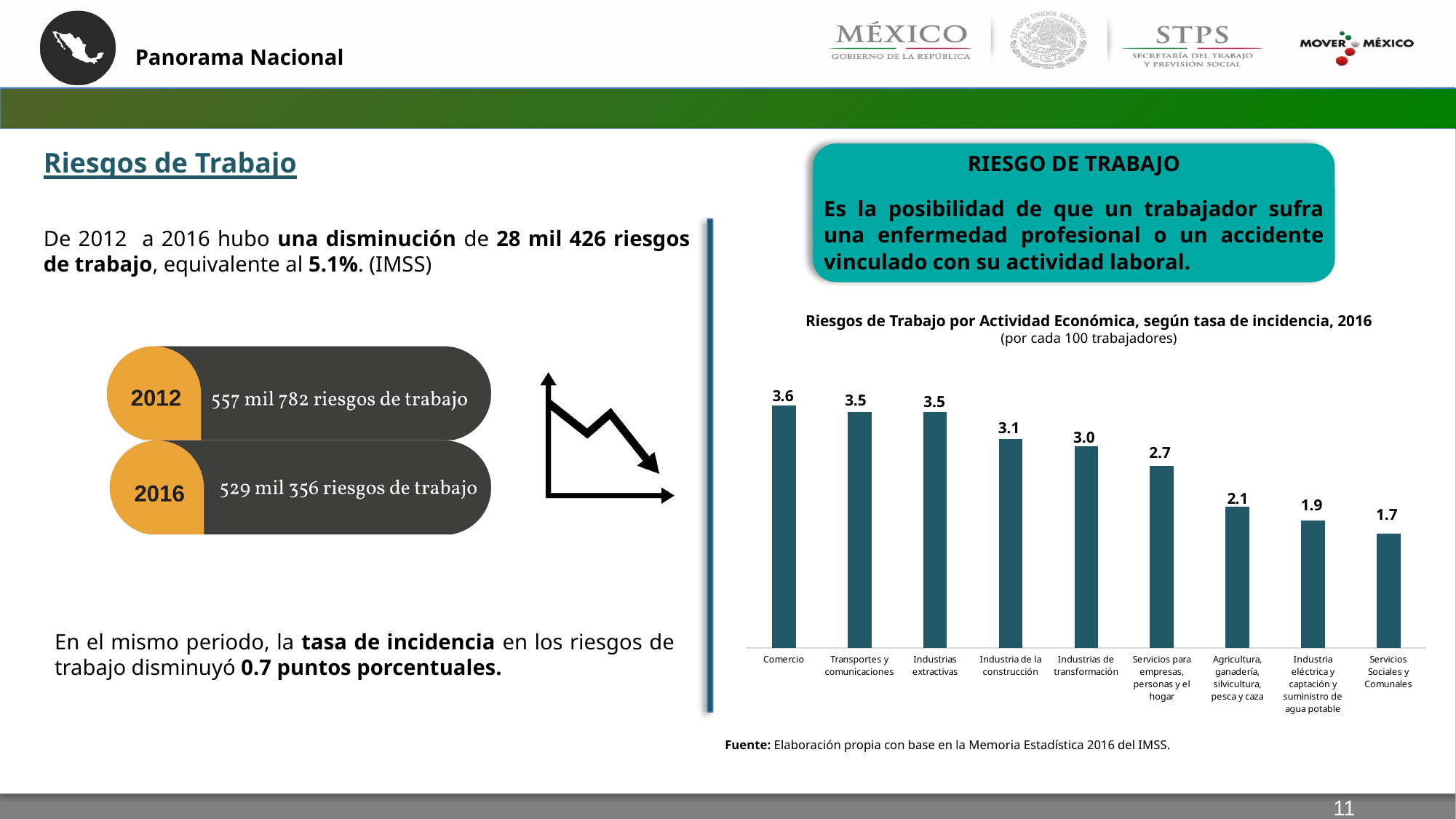
What is the incidence rate for Industria de la construcción? 3.1 What is the title of the chart? Riesgos de Trabajo por Actividad Económica, según tasa de incidencia, 2016 Do the incidence rates rise or fall from left to right across the chart? Fall Which economic activity has the highest incidence rate? Comercio What is the difference between the incidence rate for Comercio and for Servicios Sociales y Comunales? 1.9 Which economic activity has the lowest incidence rate? Servicios Sociales y Comunales What is the incidence rate for Servicios Sociales y Comunales? 1.7 Which has a higher incidence rate, Industrias de transformación or Servicios para empresas, personas y el hogar? Industrias de transformación How many economic activities are shown in the chart? 9 What is the incidence rate for Comercio? 3.6 What is the difference between the incidence rate for Agricultura, ganadería, silvicultura, pesca y caza and for Industria eléctrica y captación y suministro de agua potable? 0.2 What kind of chart is used to show the incidence rates by economic activity? Bar chart